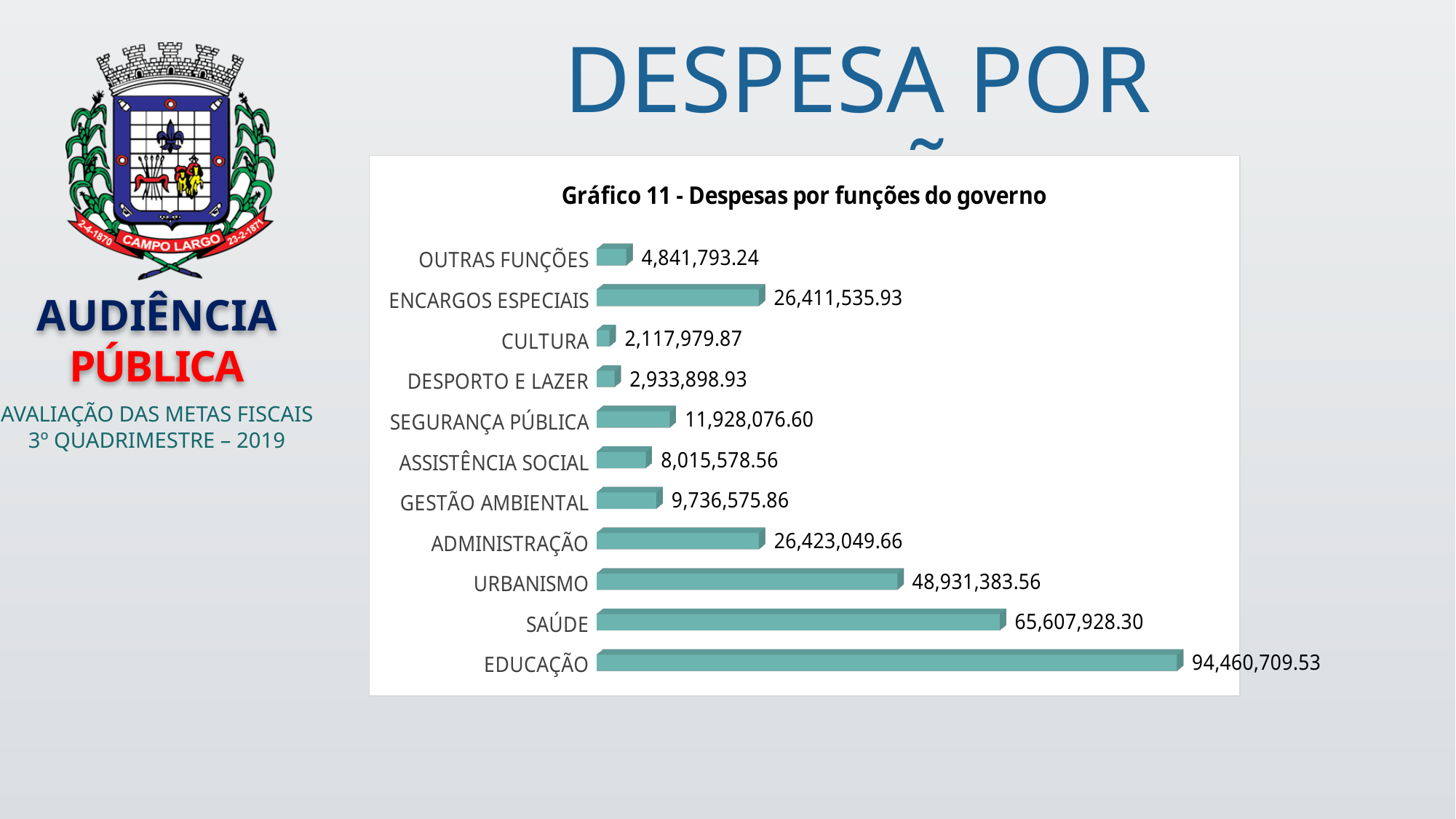
What is the value for EDUCAÇÃO? 94,460,709.53 Which function has the lowest expense? CULTURA Which is larger, the value for GESTÃO AMBIENTAL or the value for ASSISTÊNCIA SOCIAL? GESTÃO AMBIENTAL How many government functions (categories) are shown in the chart? 11 Which function has the highest expense? EDUCAÇÃO What is the title of the chart? Gráfico 11 - Despesas por funções do governo What type of chart is shown on the slide? Bar chart What is the value for URBANISMO? 48,931,383.56 What is the difference between the values for EDUCAÇÃO and SAÚDE? 28,852,781.23 What is the difference between the values for URBANISMO and ADMINISTRAÇÃO? 22,508,333.90 What is the value for SEGURANÇA PÚBLICA? 11,928,076.60 What is the value for CULTURA? 2,117,979.87